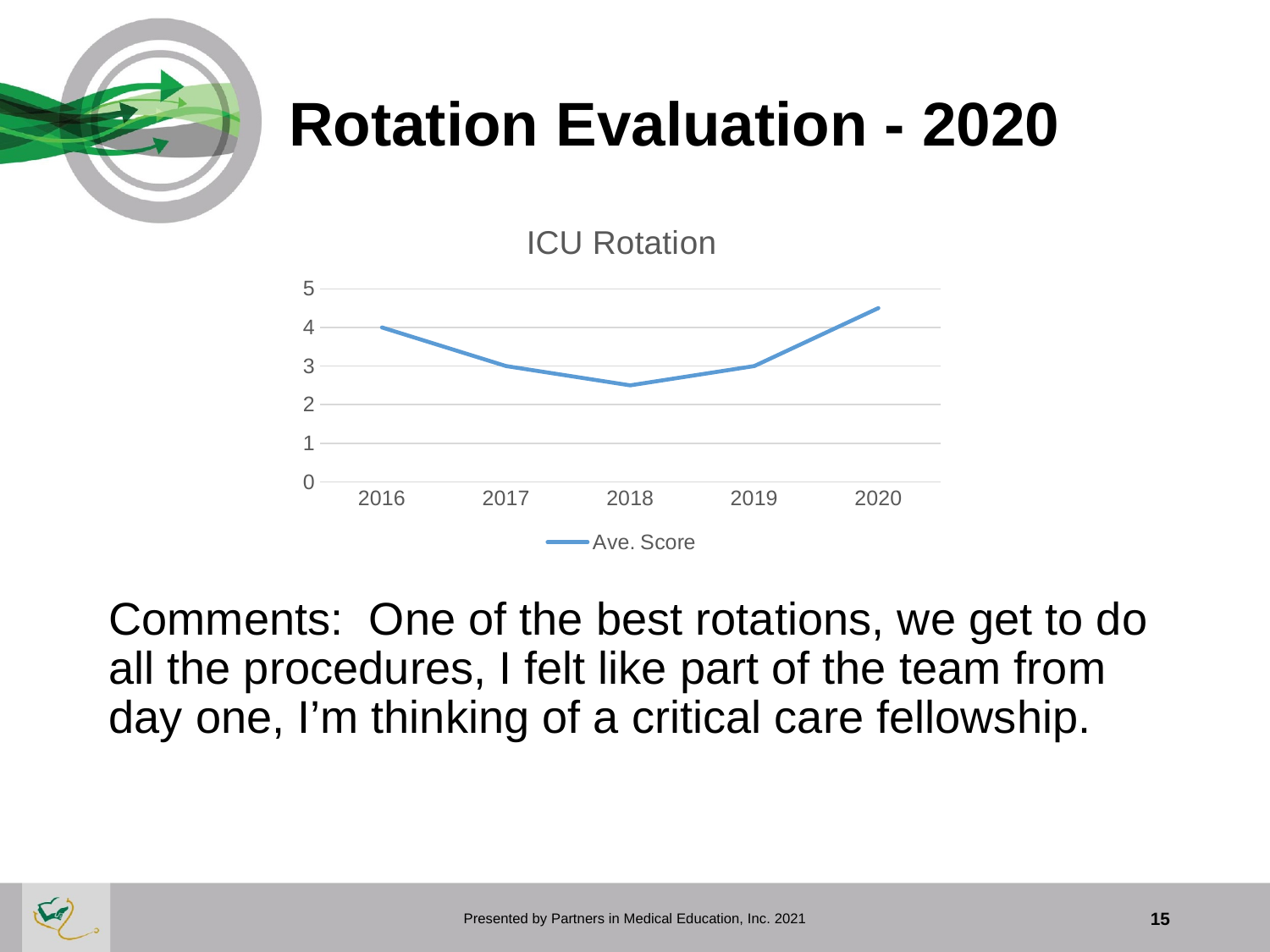
Which year has the highest Ave. Score? 2020 What series name does the chart legend show? Ave. Score What kind of chart is shown on the slide? line chart Does the Ave. Score rise or fall from 2018 to 2020? rise Is the Ave. Score for 2020 greater or less than 4? greater How many years are plotted on the x axis? 5 Which year has the lowest Ave. Score? 2018 How many series does the legend list? 1 What is the title of the chart? ICU Rotation What is the Ave. Score for 2016? 4 What is the Ave. Score for 2019? 3 Is the Ave. Score for 2018 greater or less than 3? less